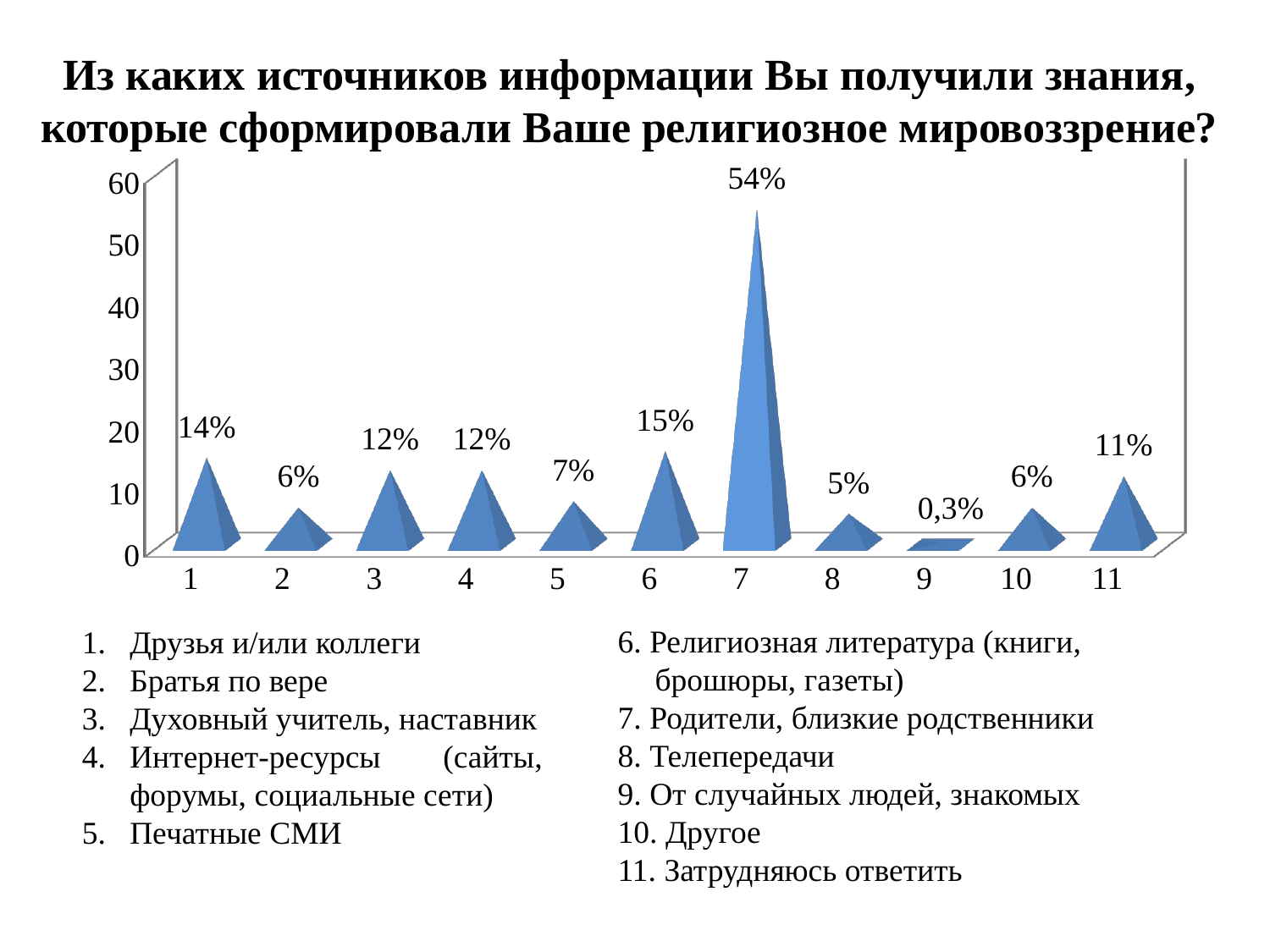
What is the value for category 9 (От случайных людей, знакомых)? 0,3% What is the difference between the values for category 7 and category 6? 39% What is the difference between the values for category 3 and category 2? 6% Which category has the lowest value? 9 Which is larger, the value for category 1 or the value for category 11? category 1 How many categories are shown on the x axis? 11 What is the value for category 6 (Религиозная литература)? 15% Which category has the highest value? 7 What is the value for category 1 (Друзья и/или коллеги)? 14% What is the value for category 7 (Родители, близкие родственники)? 54% Is the value for category 7 greater or less than 50? greater What kind of chart is shown on the slide? bar chart